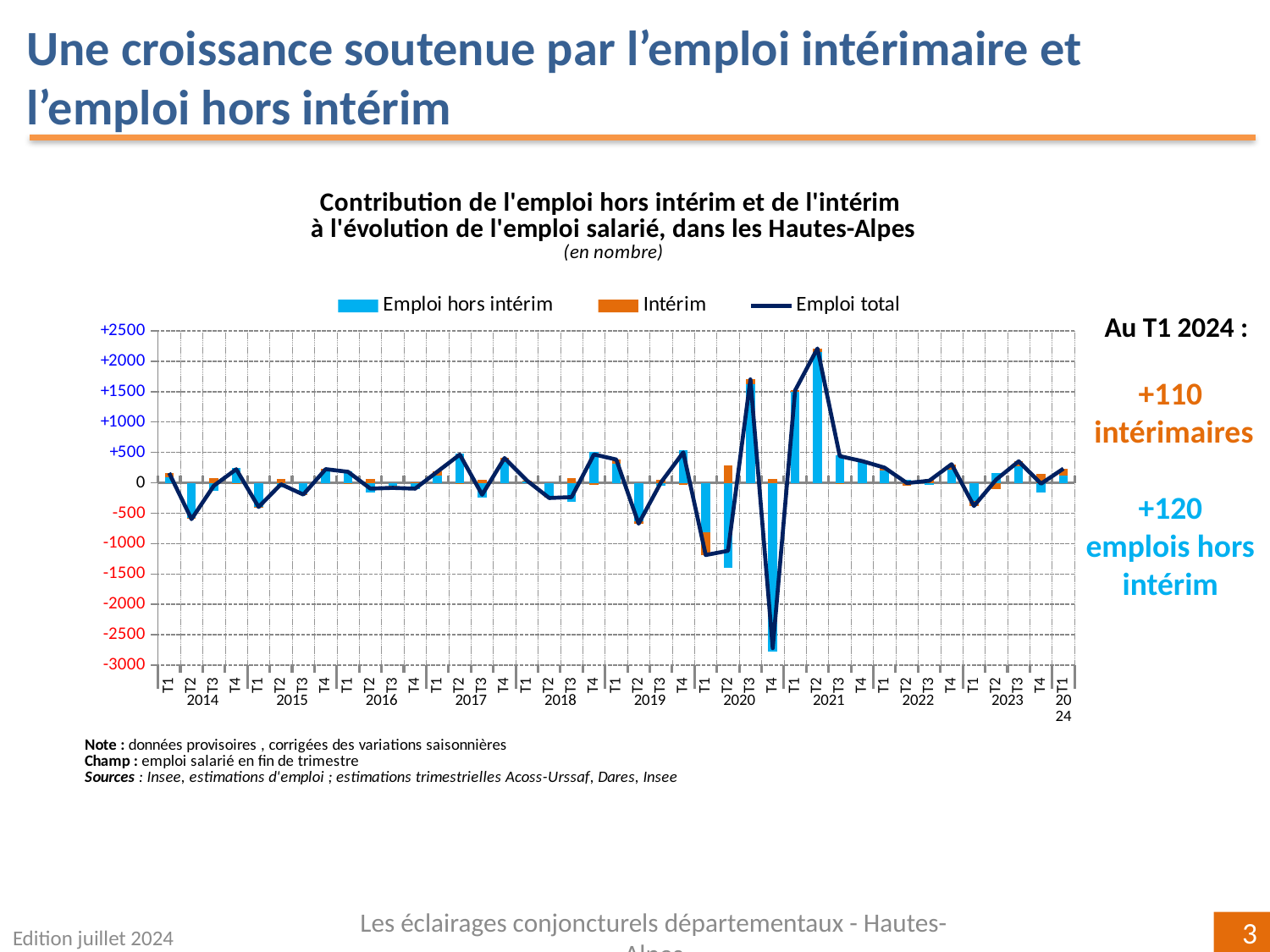
Which is larger, the Emploi total value for T2 2021 or for T3 2020? T2 2021 According to the slide, what is the contribution of intérim employment in T1 2024? +110 Is the Emploi total value for T4 2020 greater or less than -2500? less Which series is drawn as a line rather than bars? Emploi total What kind of chart is shown on the slide? A combined bar and line chart In which quarter does the Emploi total line reach its highest value? T2 2021 Is the Emploi total value for T2 2021 greater or less than 2000? greater How many years are labelled along the x axis of the chart? 11 Is the Emploi total value for T1 2020 greater or less than -1000? less According to the slide, what is the contribution of emploi hors intérim in T1 2024? +120 How many series does the chart legend list? 3 In which quarter does the Emploi total line reach its lowest value? T4 2020